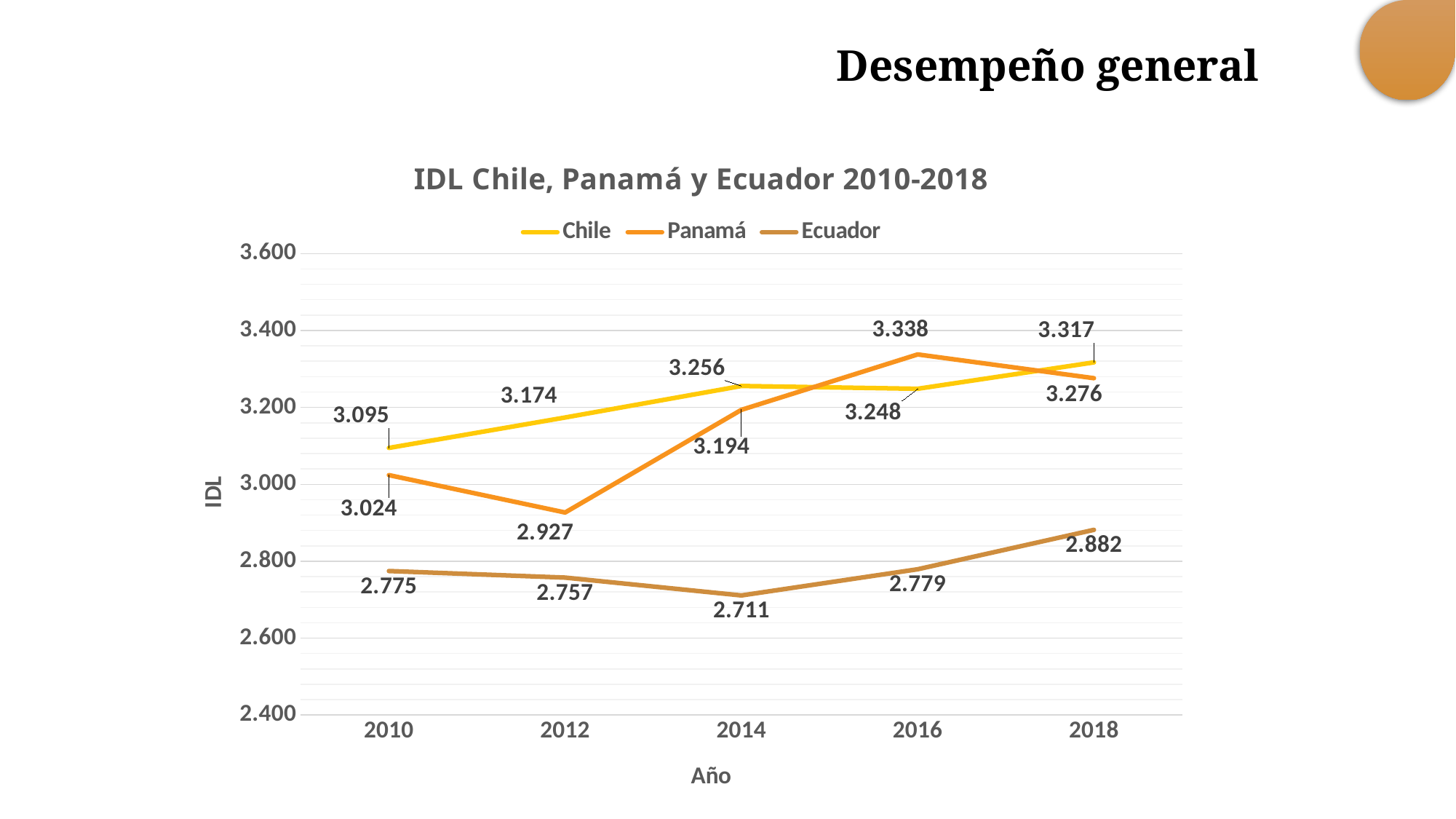
Which country has the higher IDL in 2018, Chile or Panamá? Chile What is the difference between Panamá's IDL in 2016 and in 2012? 0.411 How many series does the legend list? 3 What is the IDL value for Ecuador in 2018? 2.882 In which year does Panamá reach its highest IDL value? 2016 Does Ecuador's IDL rise or fall from 2010 to 2014? Fall Which country has the higher IDL in 2016, Chile or Panamá? Panamá What is the difference between Chile's IDL in 2018 and in 2010? 0.222 What is the IDL value for Chile in 2010? 3.095 In which year does Ecuador have its lowest IDL value? 2014 What kind of chart is shown on the slide? Line chart What is the IDL value for Panamá in 2012? 2.927